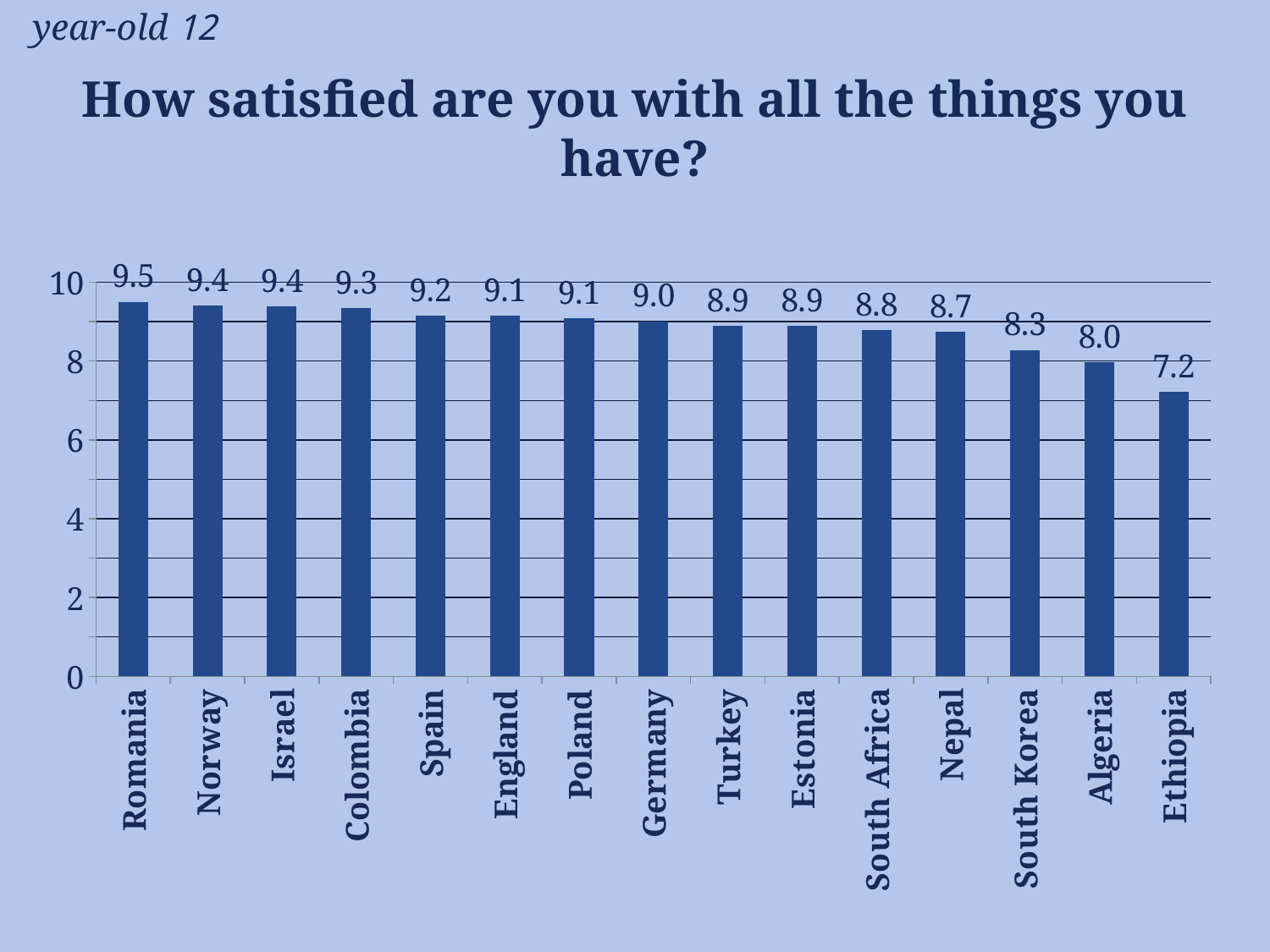
Which is larger, the value for Spain or the value for South Korea? Spain Which country has the lowest value? Ethiopia What is the value for South Korea? 8.3 What is the difference between the values for Nepal and Algeria? 0.7 What is the value for Romania? 9.5 How many countries are shown in the chart? 15 Which country has the highest value? Romania What is the value for Ethiopia? 7.2 What is the difference between the values for Romania and Ethiopia? 2.3 Do the values rise or fall from left to right along the x axis? Fall What kind of chart is shown on the slide? Bar chart What is the value for Germany? 9.0